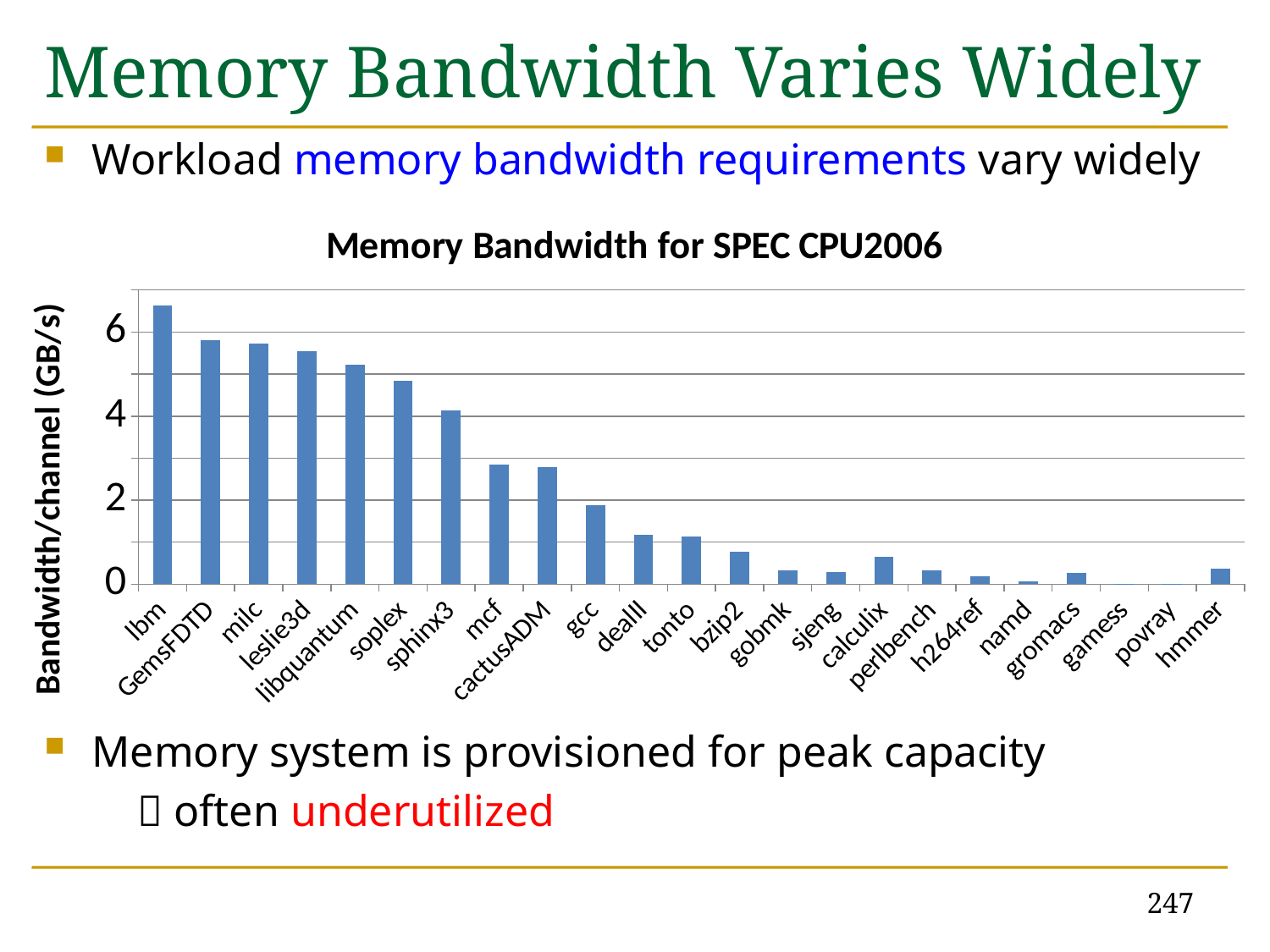
Is the value for gcc greater or less than 2? less Which benchmark has the highest memory bandwidth? lbm Is the value for mcf greater or less than 4? less How many benchmarks (categories) are plotted on the x axis? 23 What is the label of the vertical axis? Bandwidth/channel (GB/s) Is the value for soplex greater or less than 4? greater What kind of chart is shown on the slide? bar chart Which has a higher memory bandwidth, milc or cactusADM? milc Which has a higher memory bandwidth, gobmk or mcf? mcf What is the title of the chart? Memory Bandwidth for SPEC CPU2006 Do the bar values generally rise or fall from left to right along the x axis? fall